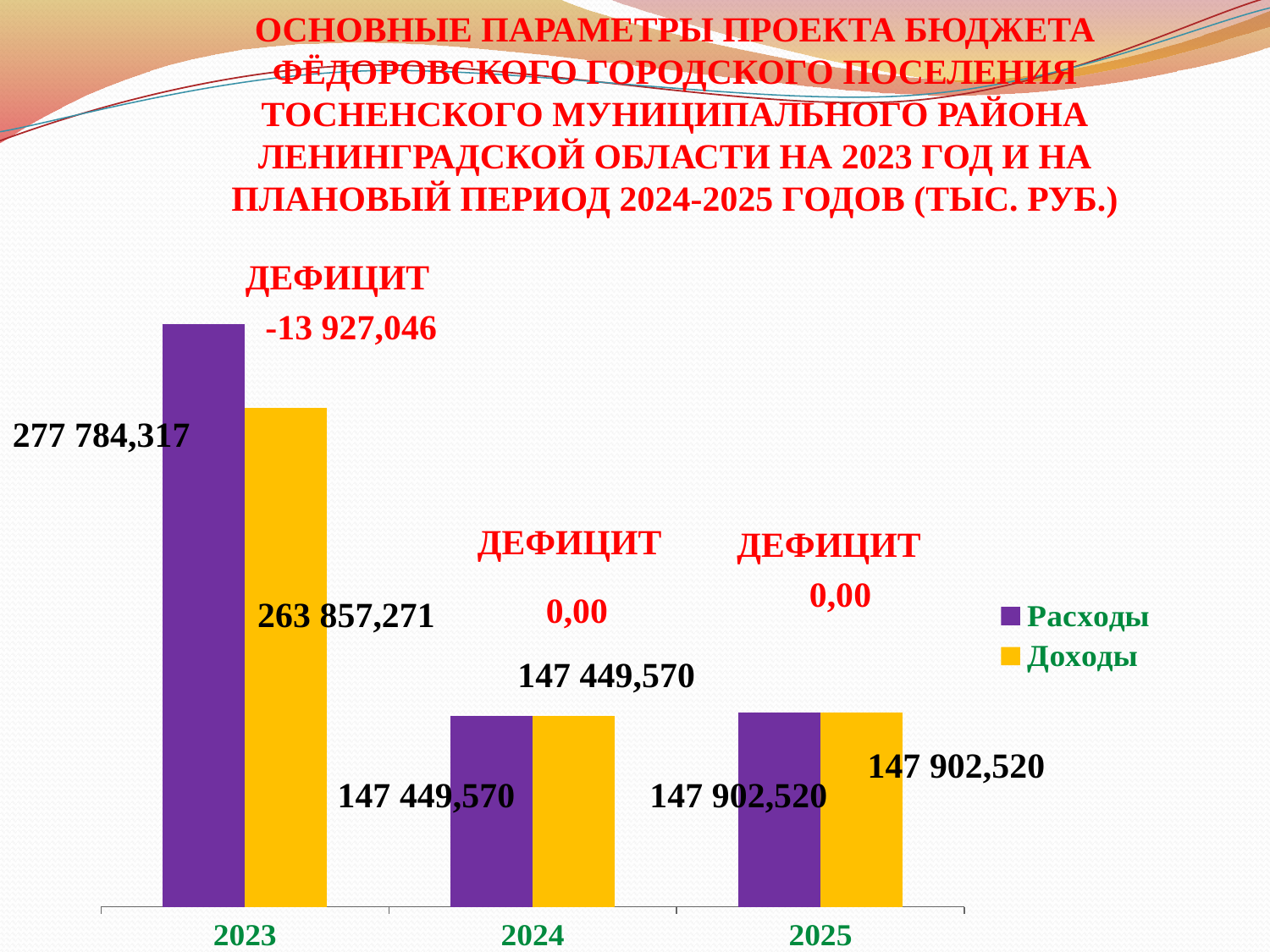
In which year is Доходы the lowest? 2024 What is the difference between Расходы and Доходы in 2023? 13 927,046 How many series does the legend list? 2 What deficit (ДЕФИЦИТ) value is shown for 2024? 0,00 Which is larger in 2023, Расходы or Доходы? Расходы What is the value of Доходы for 2024? 147 449,570 What is the value of Расходы for 2025? 147 902,520 What is the value of Расходы for 2023? 277 784,317 In which year is Расходы the highest? 2023 What type of chart is shown on the slide? bar chart What is the value of Доходы for 2023? 263 857,271 How many years are shown on the x axis? 3